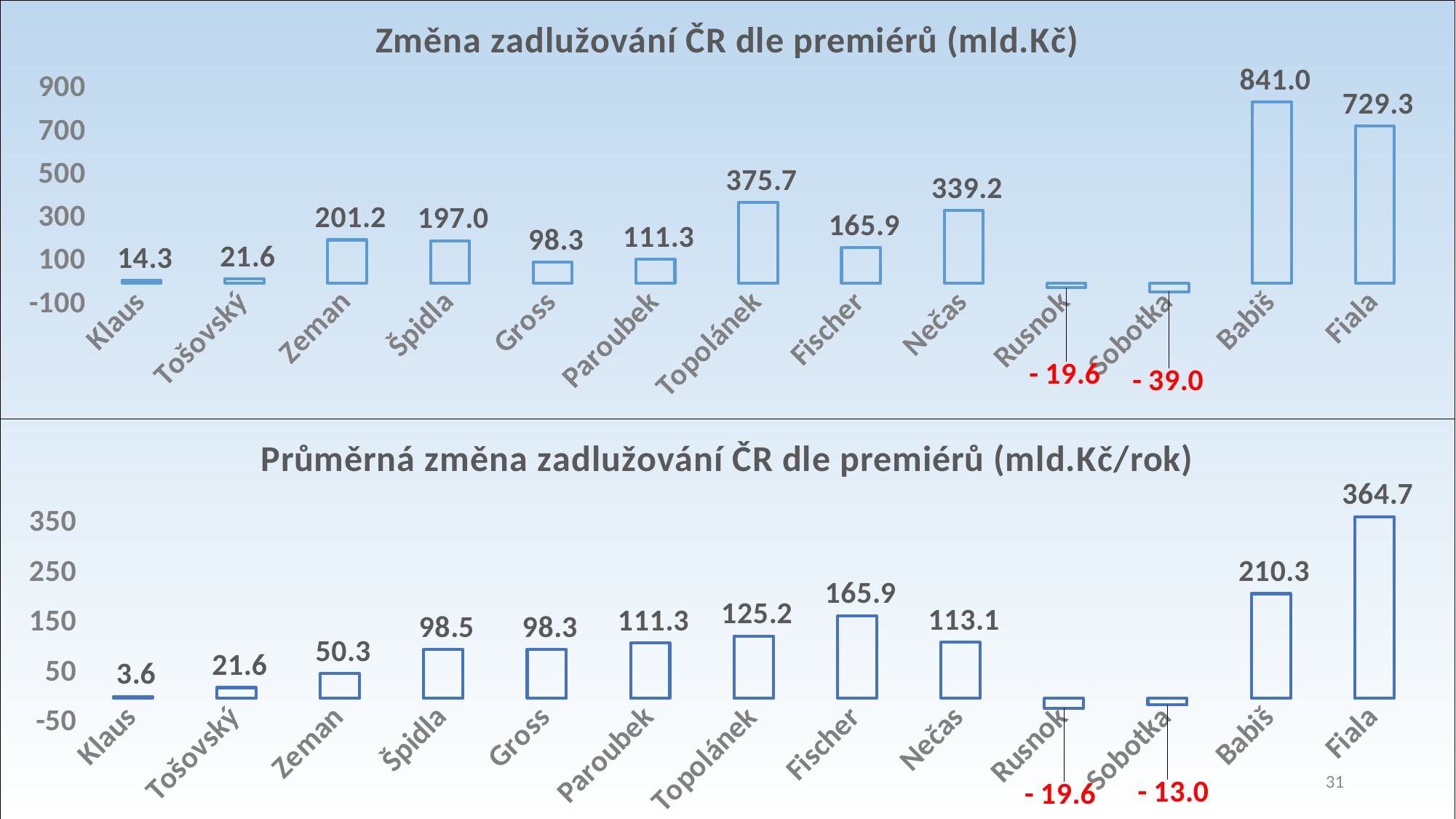
In the bottom chart (Průměrná změna zadlužování ČR dle premiérů), what is the value for Zeman? 50.3 In the top chart (Změna zadlužování ČR dle premiérů), what is the value for Topolánek? 375.7 In the bottom chart (Průměrná změna zadlužování ČR dle premiérů), which prime minister has the highest value? Fiala In the bottom chart (Průměrná změna zadlužování ČR dle premiérů), what is the difference between the values for Fiala and Babiš? 154.4 In the bottom chart (Průměrná změna zadlužování ČR dle premiérů), which is larger, the value for Fischer or the value for Nečas? Fischer What is the title of the top chart? Změna zadlužování ČR dle premiérů (mld.Kč) What type of chart is the bottom chart (Průměrná změna zadlužování ČR dle premiérů)? Bar chart In the top chart (Změna zadlužování ČR dle premiérů), how many prime ministers are shown? 13 In the top chart (Změna zadlužování ČR dle premiérů), what is the value for Babiš? 841.0 In the top chart (Změna zadlužování ČR dle premiérů), what is the difference between the values for Babiš and Fiala? 111.7 In the top chart (Změna zadlužování ČR dle premiérů), what is the value for Sobotka? - 39.0 In the top chart (Změna zadlužování ČR dle premiérů), which prime minister has the lowest value? Sobotka